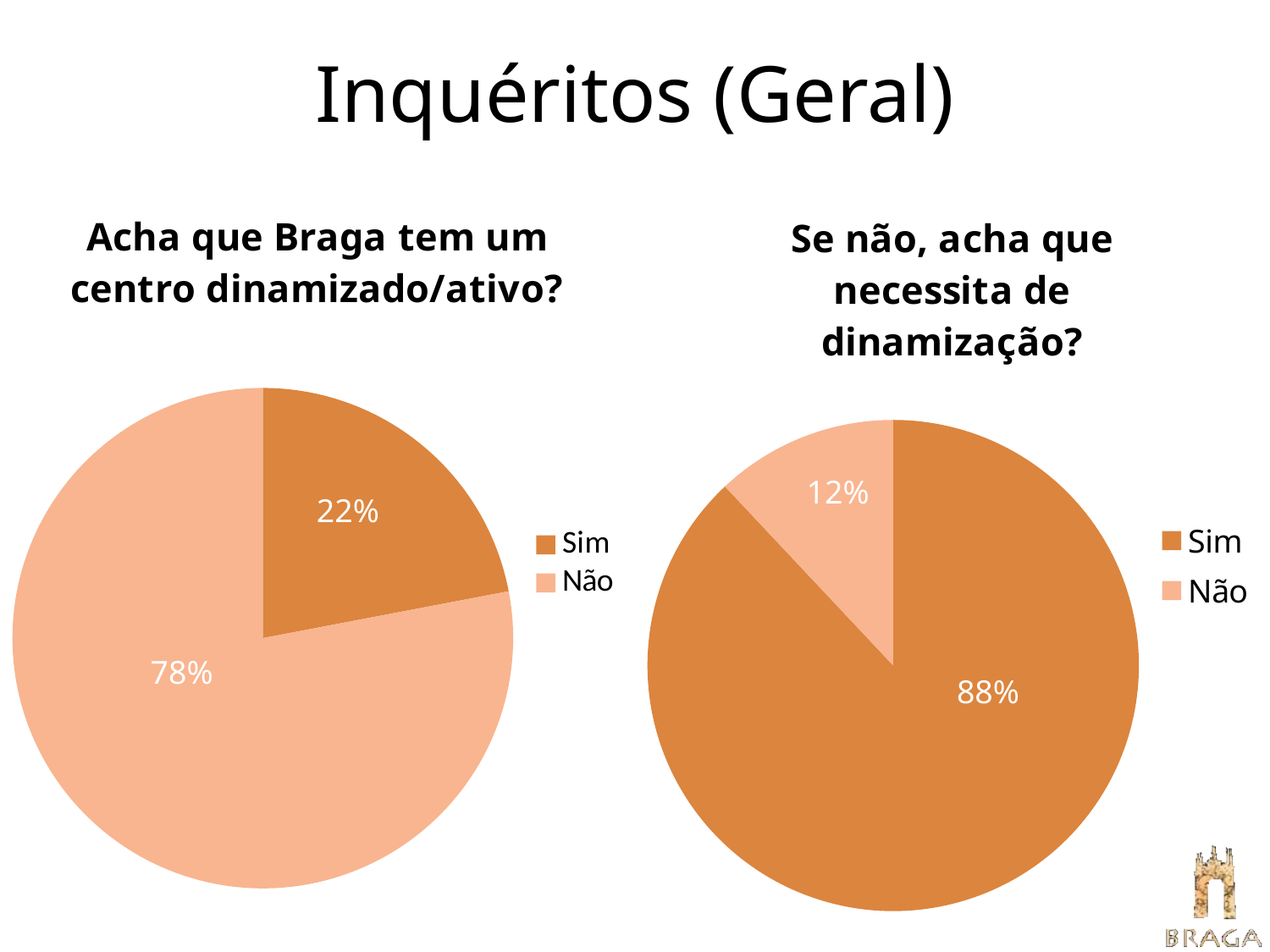
In the right chart 'Se não, acha que necessita de dinamização?', what is the difference between the 'Sim' and 'Não' shares? 76% In the right chart 'Se não, acha que necessita de dinamização?', which is larger, 'Sim' or 'Não'? Sim In the right chart 'Se não, acha que necessita de dinamização?', which category has the smallest slice? Não In the right chart 'Se não, acha que necessita de dinamização?', what share of responses is 'Sim'? 88% In the left chart 'Acha que Braga tem um centro dinamizado/ativo?', what is the difference between the 'Não' and 'Sim' shares? 56% In the left chart 'Acha que Braga tem um centro dinamizado/ativo?', which category has the largest slice? Não In the left chart 'Acha que Braga tem um centro dinamizado/ativo?', what share of responses is 'Sim'? 22% How many categories does the legend of the right chart 'Se não, acha que necessita de dinamização?' list? 2 In the left chart 'Acha que Braga tem um centro dinamizado/ativo?', what share of responses is 'Não'? 78% What is the title of the left chart? Acha que Braga tem um centro dinamizado/ativo? What kind of chart is the left chart 'Acha que Braga tem um centro dinamizado/ativo?'? Pie chart In the right chart 'Se não, acha que necessita de dinamização?', what share of responses is 'Não'? 12%